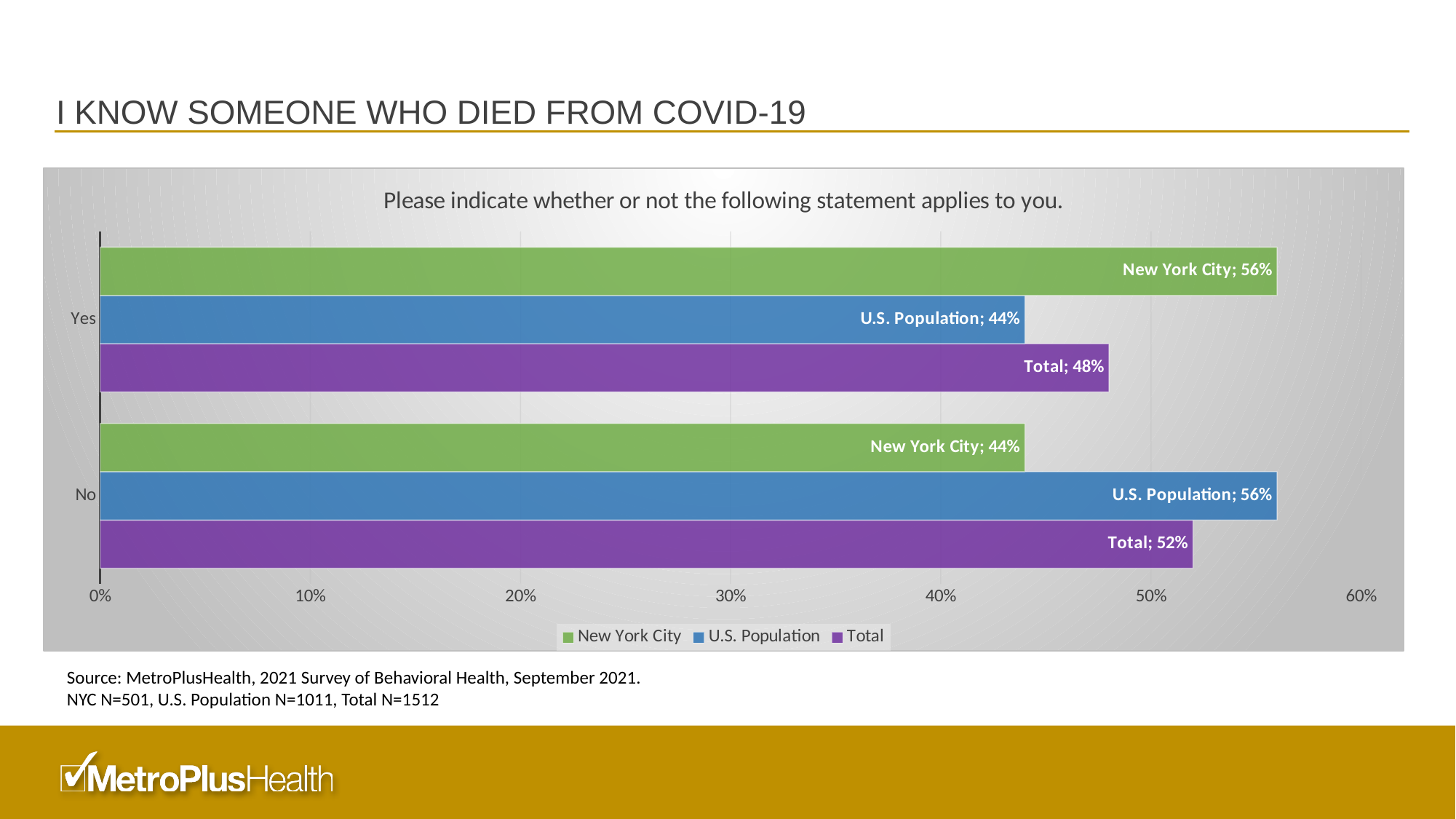
Which series has the lowest value in the No category? New York City Is the U.S. Population value for Yes greater or less than 50%? less What colour represents the Total series? purple What is the difference between the New York City and U.S. Population values for Yes? 12% What is the Total value for the No category? 52% What is the Total value for the Yes category? 48% How many series does the legend list? 3 What kind of chart is shown on the slide? bar chart Which is larger for the Total series: the Yes value or the No value? No What is the U.S. Population value for the No category? 56% Which series has the highest value in the Yes category? New York City What percentage of New York City respondents answered Yes? 56%